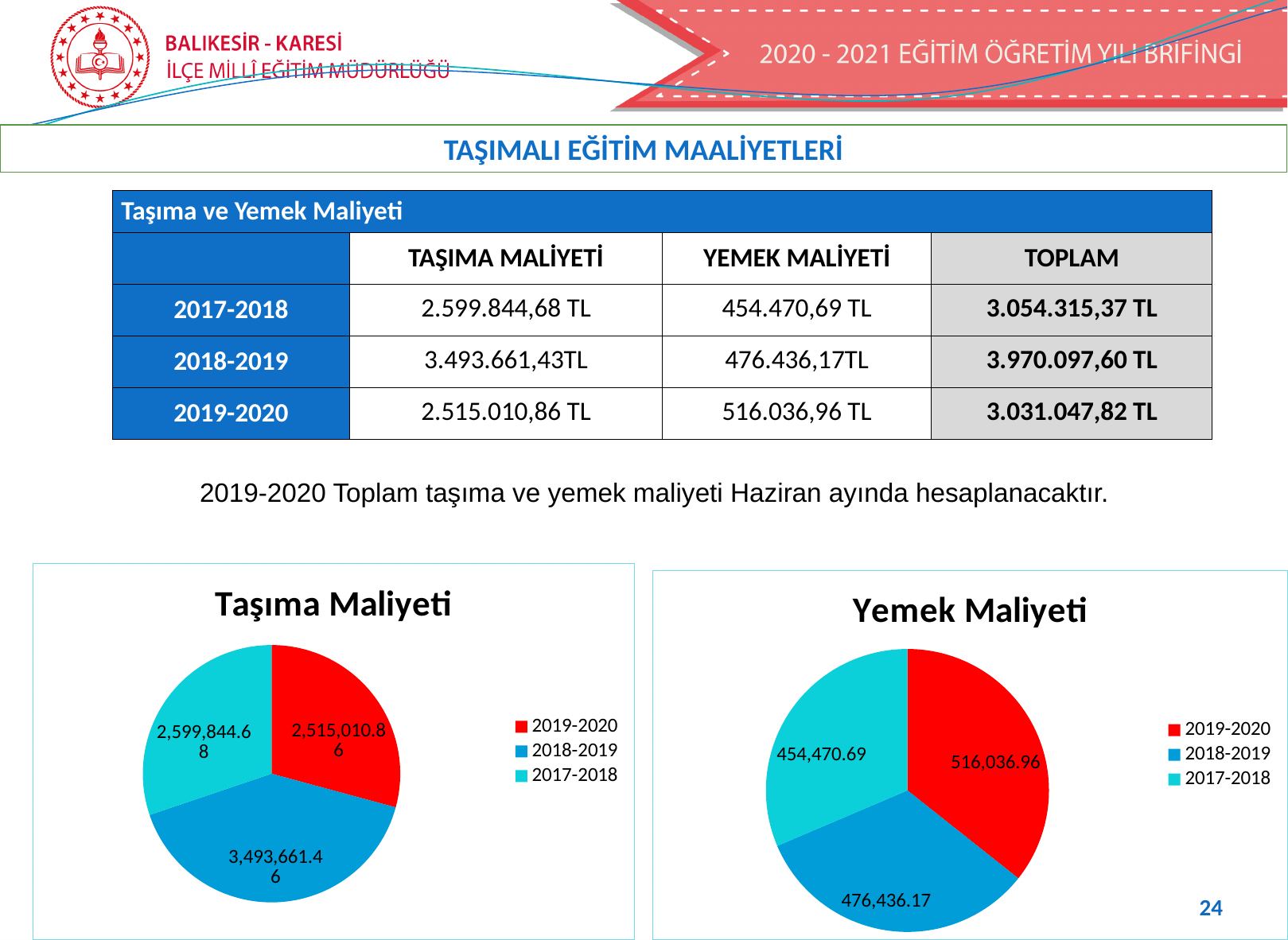
In the Yemek Maliyeti pie chart, what is the value for 2019-2020? 516,036.96 In the Taşıma Maliyeti pie chart, which is larger, the value for 2017-2018 or the value for 2019-2020? 2017-2018 In the Yemek Maliyeti pie chart, what is the value for 2017-2018? 454,470.69 In the Taşıma Maliyeti pie chart, what is the value for 2019-2020? 2,515,010.86 What type of chart is the Yemek Maliyeti chart? Pie chart In the Taşıma Maliyeti pie chart, what is the value for 2018-2019? 3,493,661.46 In the Yemek Maliyeti pie chart, which year has the largest slice? 2019-2020 In the Yemek Maliyeti pie chart, what is the difference between the 2019-2020 and 2018-2019 values? 39,600.79 In the Yemek Maliyeti pie chart, which year has the smallest slice? 2017-2018 In the Taşıma Maliyeti pie chart, what is the difference between the 2018-2019 and 2017-2018 values? 893,816.78 How many entries does the legend of the Taşıma Maliyeti chart list? 3 In the Taşıma Maliyeti pie chart, which year has the largest slice? 2018-2019